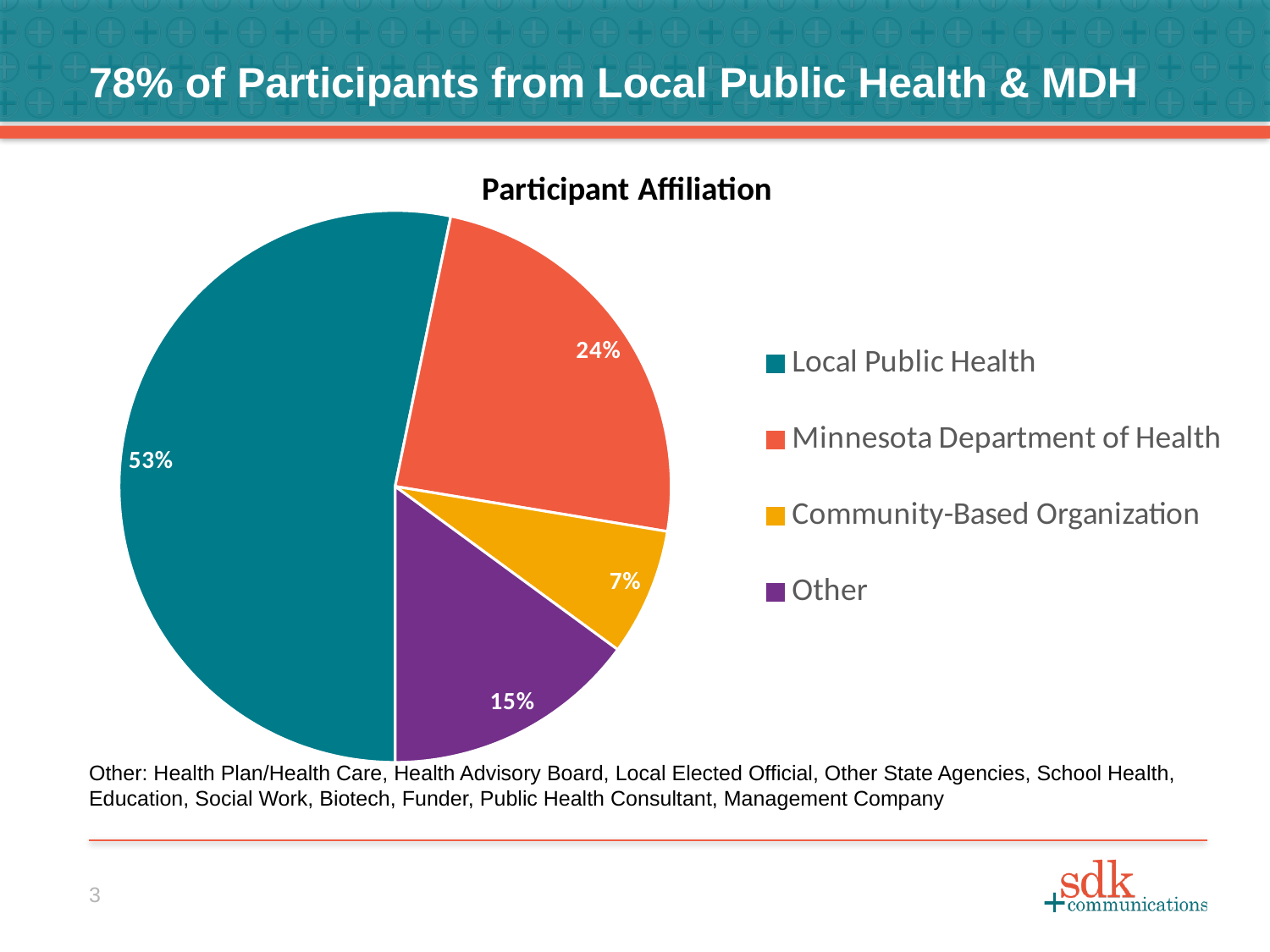
Which affiliation has the largest share of participants? Local Public Health What share of participants are from Local Public Health? 53% What is the title of the chart? Participant Affiliation What share of participants fall under Other? 15% What share of participants are from the Minnesota Department of Health? 24% What kind of chart is shown on the slide? Pie chart What share of participants are from a Community-Based Organization? 7% How many percentage points larger is the Local Public Health share than the Minnesota Department of Health share? 29 How many affiliation categories does the pie chart show? 4 What colour is the Minnesota Department of Health slice? Orange Which affiliation has the smallest share of participants? Community-Based Organization Which is larger: the share for Other or the share for Community-Based Organization? Other